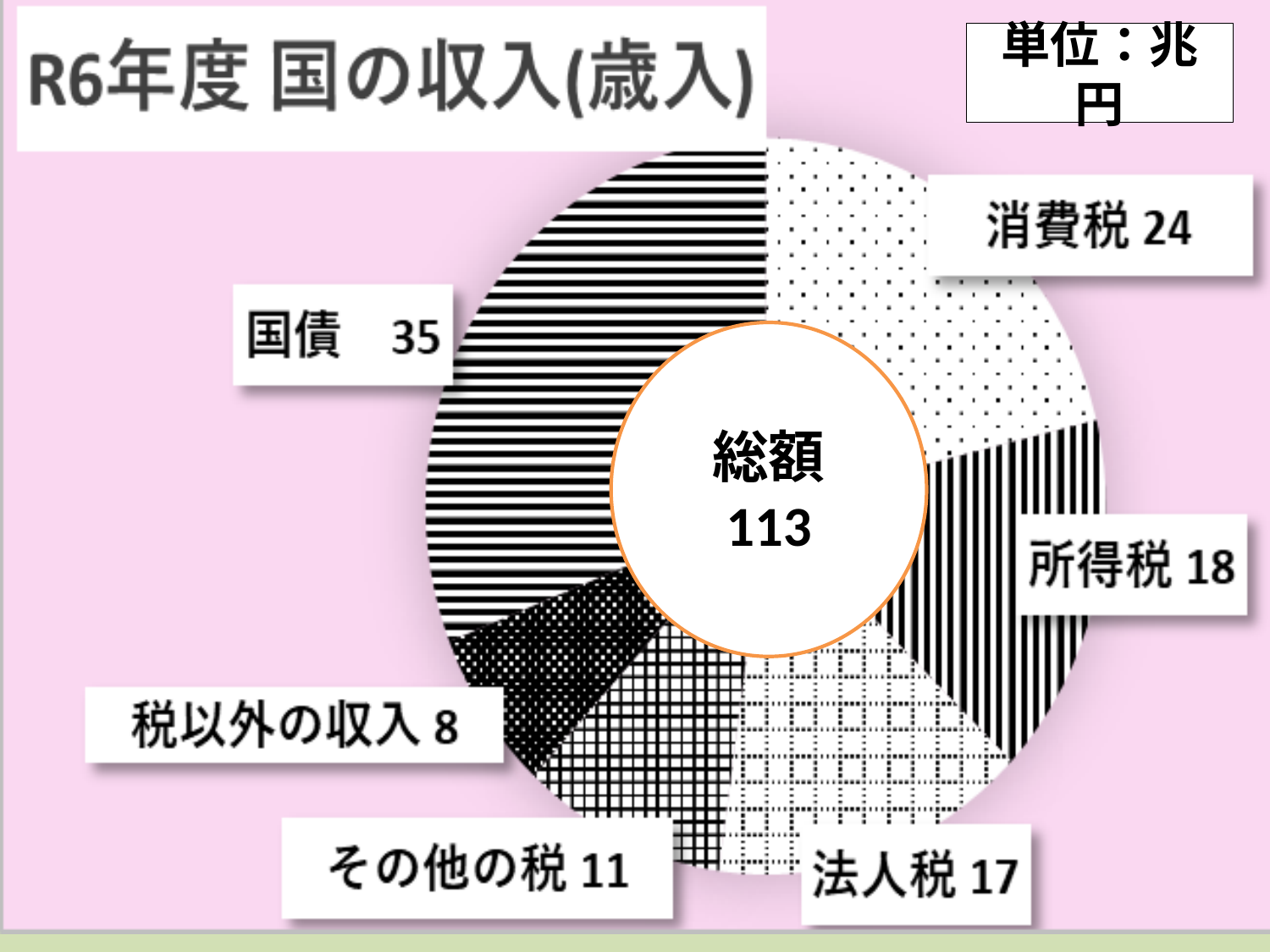
What is the value for 国債 in the pie chart? 35 Which category has the smallest slice in the pie chart? 税以外の収入 What is the value for 法人税 in the pie chart? 17 What is the difference between the values for 国債 and 消費税? 11 Which is larger, 所得税 or その他の税? 所得税 What is the value for 消費税 in the pie chart? 24 What is the difference between the values for 所得税 and 法人税? 1 What unit is stated for the values in the chart? 兆円 What total is shown in the centre of the pie chart? 113 Which category has the largest slice in the pie chart? 国債 What type of chart is shown on the slide? pie chart How many categories are shown in the pie chart? 6